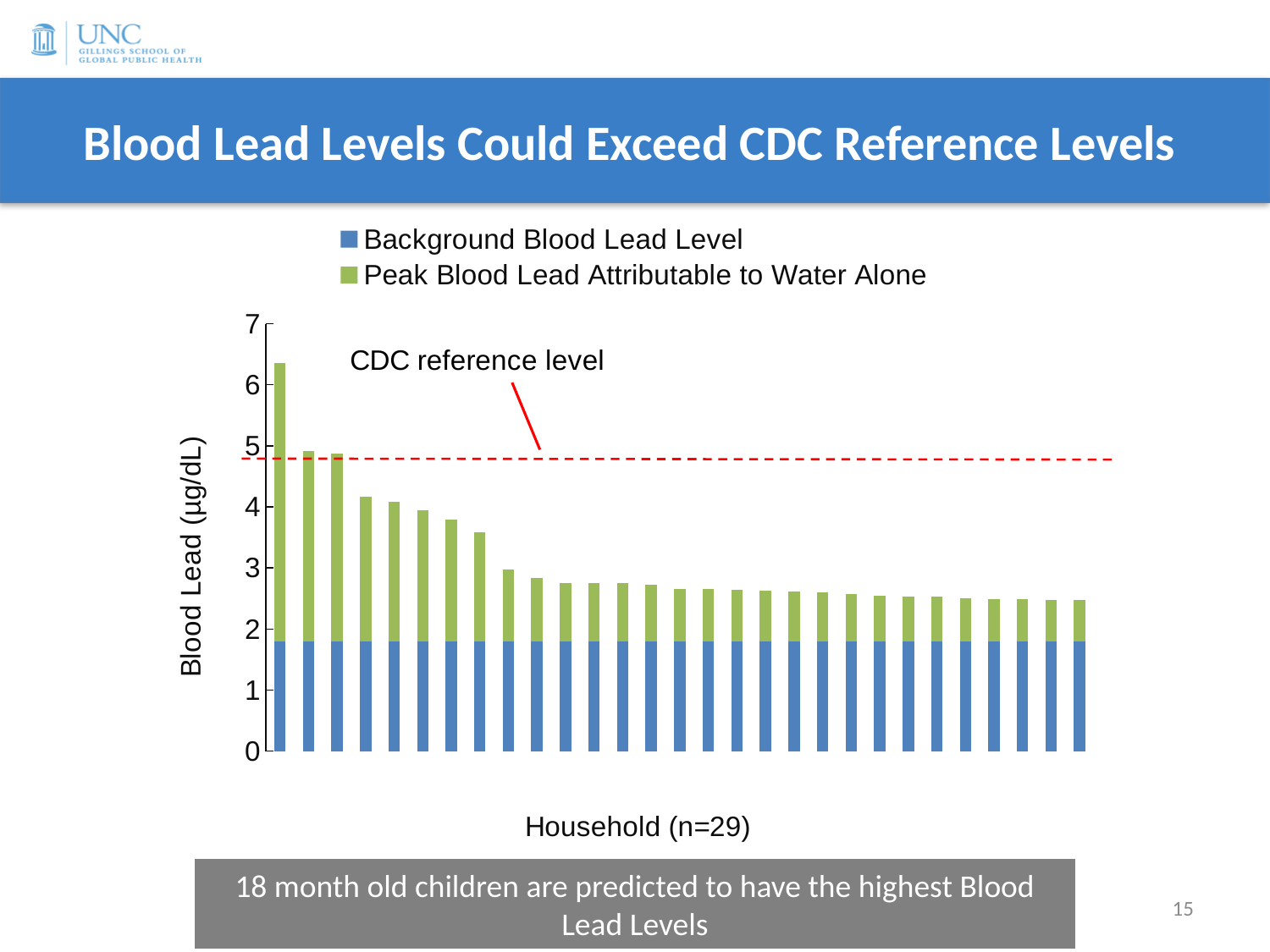
Is the total blood lead level for the leftmost household greater or less than 6? greater Is the Background Blood Lead Level for each household greater or less than 2? less Is the total blood lead level for the rightmost household greater or less than 3? less How many households are plotted in the chart? 29 How many series does the chart legend list? 2 What is the title of the slide's chart? Blood Lead Levels Could Exceed CDC Reference Levels Do the total blood lead levels rise or fall moving from left to right across the households? fall What is the label on the y axis of the chart? Blood Lead (µg/dL) What kind of chart is shown on the slide? Stacked bar chart Which is larger, the total blood lead level for the leftmost household or for the second household from the left? The leftmost household Which household has the highest total predicted blood lead level? The leftmost (first) household